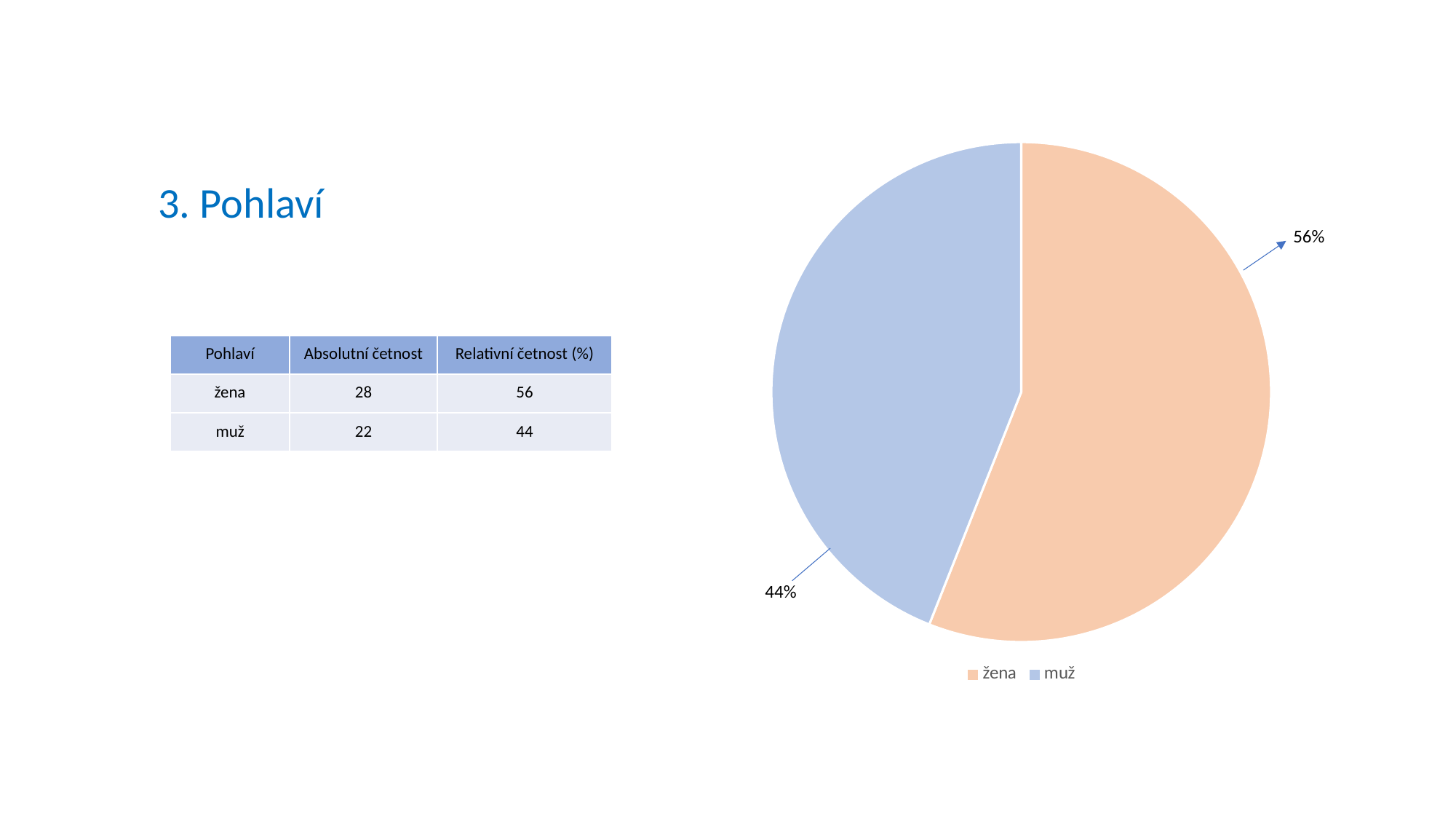
Which slice is larger, žena or muž? žena What colour is the žena slice in the pie chart? orange How many slices does the pie chart have? 2 What kind of chart is shown on the slide? pie chart What colour is the muž slice in the pie chart? blue How many entries does the legend list? 2 What is the difference in percentage points between the žena and muž slices? 12 Which category has the largest slice of the pie? žena What share of the pie does the muž slice represent? 44% Which category has the smallest slice of the pie? muž What share of the pie does the žena slice represent? 56%